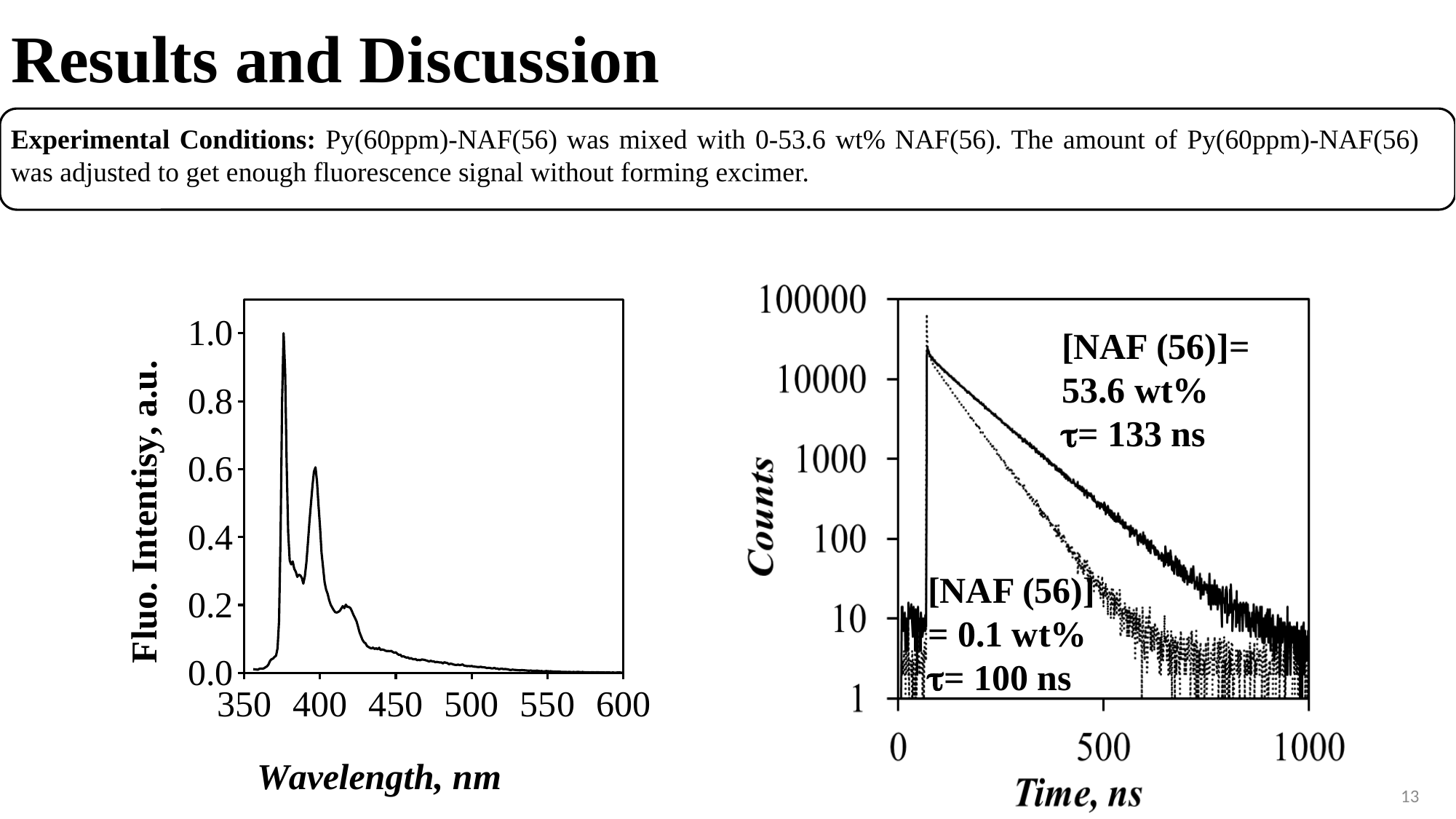
On the left chart, is the highest peak of the spectrum greater or less than 0.8? greater On the left chart, does the fluorescence intensity rise or fall between 450 nm and 600 nm? fall On the left chart, what is the x-axis label? Wavelength, nm On the left chart, what is the maximum value shown on the y axis? 1.0 On the right chart, do the counts rise or fall as time increases from 100 ns to 1000 ns? fall On the right chart, what is the difference between the lifetimes τ of the 53.6 wt% and 0.1 wt% samples? 33 ns On the right chart, which NAF (56) concentration has the longer lifetime τ, 53.6 wt% or 0.1 wt%? 53.6 wt% What type of chart is the left chart (Fluo. Intensity vs Wavelength)? line chart On the right chart (Counts vs Time), what is the lifetime τ for [NAF (56)] = 0.1 wt%? 100 ns On the right chart, how many decay curves are plotted? 2 On the left chart, is the fluorescence intensity at 500 nm greater or less than 0.2? less On the right chart (Counts vs Time), what is the lifetime τ for [NAF (56)] = 53.6 wt%? 133 ns